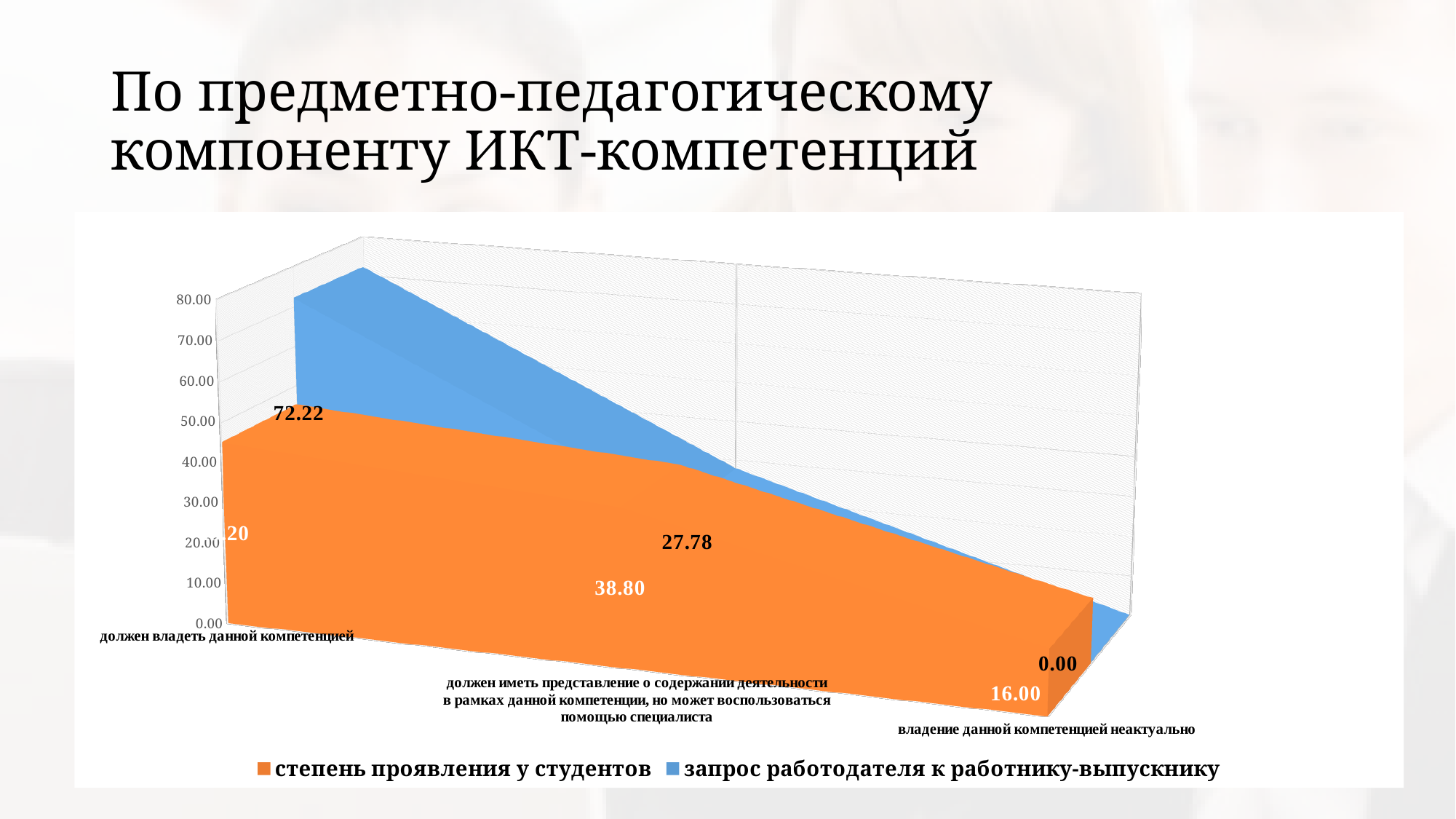
For which category is 'запрос работодателя к работнику-выпускнику' highest? должен владеть данной компетенцией How many series does the legend list? 2 For 'должен владеть данной компетенцией', which series has the larger value: 'степень проявления у студентов' or 'запрос работодателя к работнику-выпускнику'? запрос работодателя к работнику-выпускнику What is the difference between the 'запрос работодателя к работнику-выпускнику' values for 'должен владеть данной компетенцией' and for 'должен иметь представление о содержании деятельности...'? 44.44 For which category is 'степень проявления у студентов' lowest? владение данной компетенцией неактуально What is the value of 'запрос работодателя к работнику-выпускнику' for 'должен владеть данной компетенцией'? 72.22 Does the 'запрос работодателя к работнику-выпускнику' series rise or fall along the x axis? fall How many categories are plotted along the x axis? 3 What is the value of 'запрос работодателя к работнику-выпускнику' for 'владение данной компетенцией неактуально'? 0.00 What type of chart is shown on the slide? area chart What is the value of 'степень проявления у студентов' for 'должен иметь представление о содержании деятельности в рамках данной компетенции, но может воспользоваться помощью специалиста'? 38.80 What is the value of 'степень проявления у студентов' for 'владение данной компетенцией неактуально'? 16.00